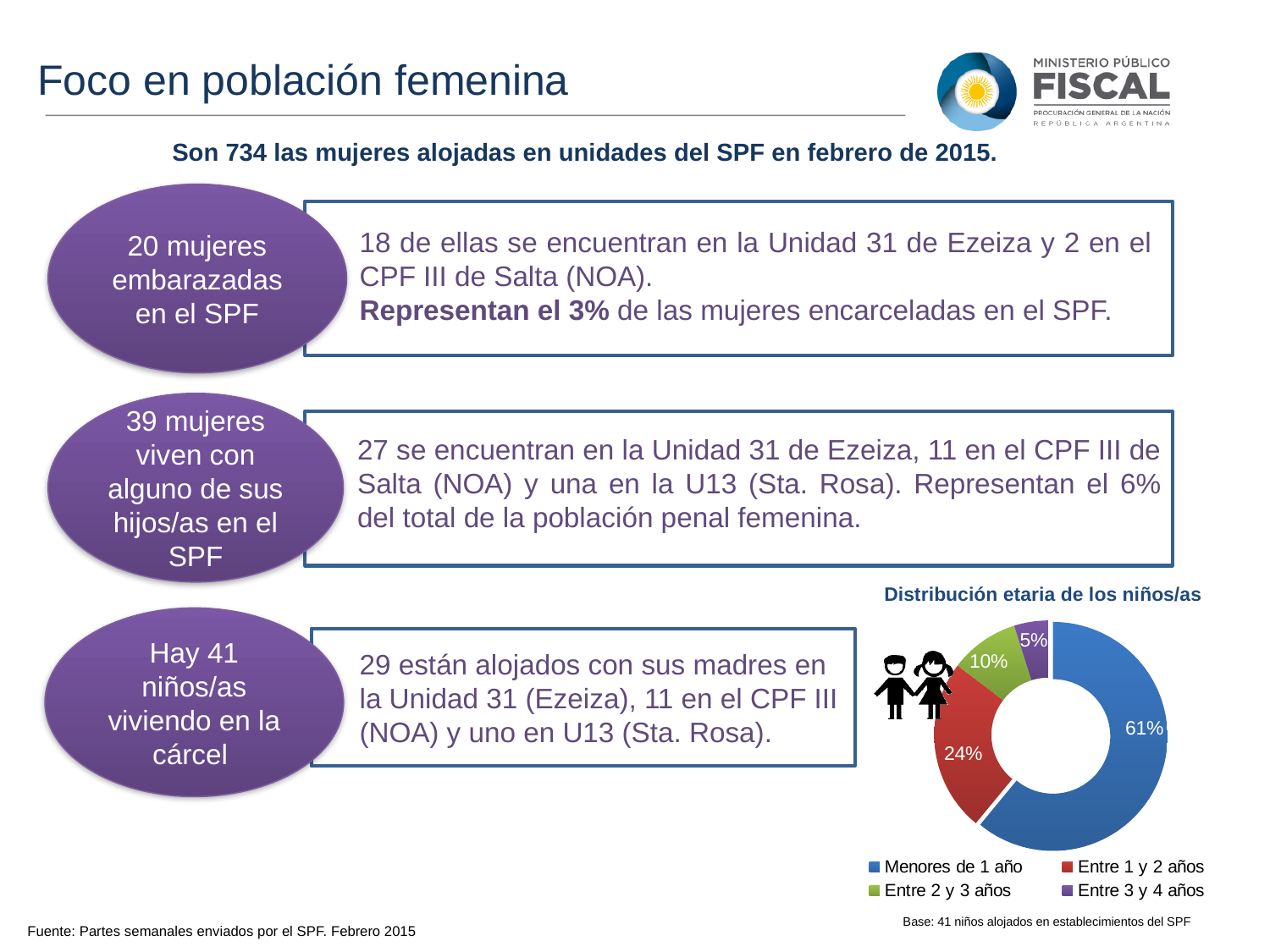
What type of chart is shown under the title 'Distribución etaria de los niños/as'? Pie chart (doughnut) What share of the children are 'Entre 2 y 3 años' in the 'Distribución etaria de los niños/as' chart? 10% What share of the children are 'Entre 1 y 2 años' in the 'Distribución etaria de los niños/as' chart? 24% Which age group has the largest share in the 'Distribución etaria de los niños/as' chart? Menores de 1 año What colour represents 'Menores de 1 año' in the 'Distribución etaria de los niños/as' chart? Blue Which age group has the smallest share in the 'Distribución etaria de los niños/as' chart? Entre 3 y 4 años What share of the children are 'Entre 3 y 4 años' in the 'Distribución etaria de los niños/as' chart? 5% In the 'Distribución etaria de los niños/as' chart, what is the difference in percentage points between 'Menores de 1 año' and 'Entre 1 y 2 años'? 37 percentage points How many age groups are shown in the 'Distribución etaria de los niños/as' chart? 4 In the 'Distribución etaria de los niños/as' chart, which is larger: the share for 'Entre 2 y 3 años' or 'Entre 3 y 4 años'? Entre 2 y 3 años What share of the children are 'Menores de 1 año' in the 'Distribución etaria de los niños/as' chart? 61% According to the note below the 'Distribución etaria de los niños/as' chart, how many children form the base of the chart? 41